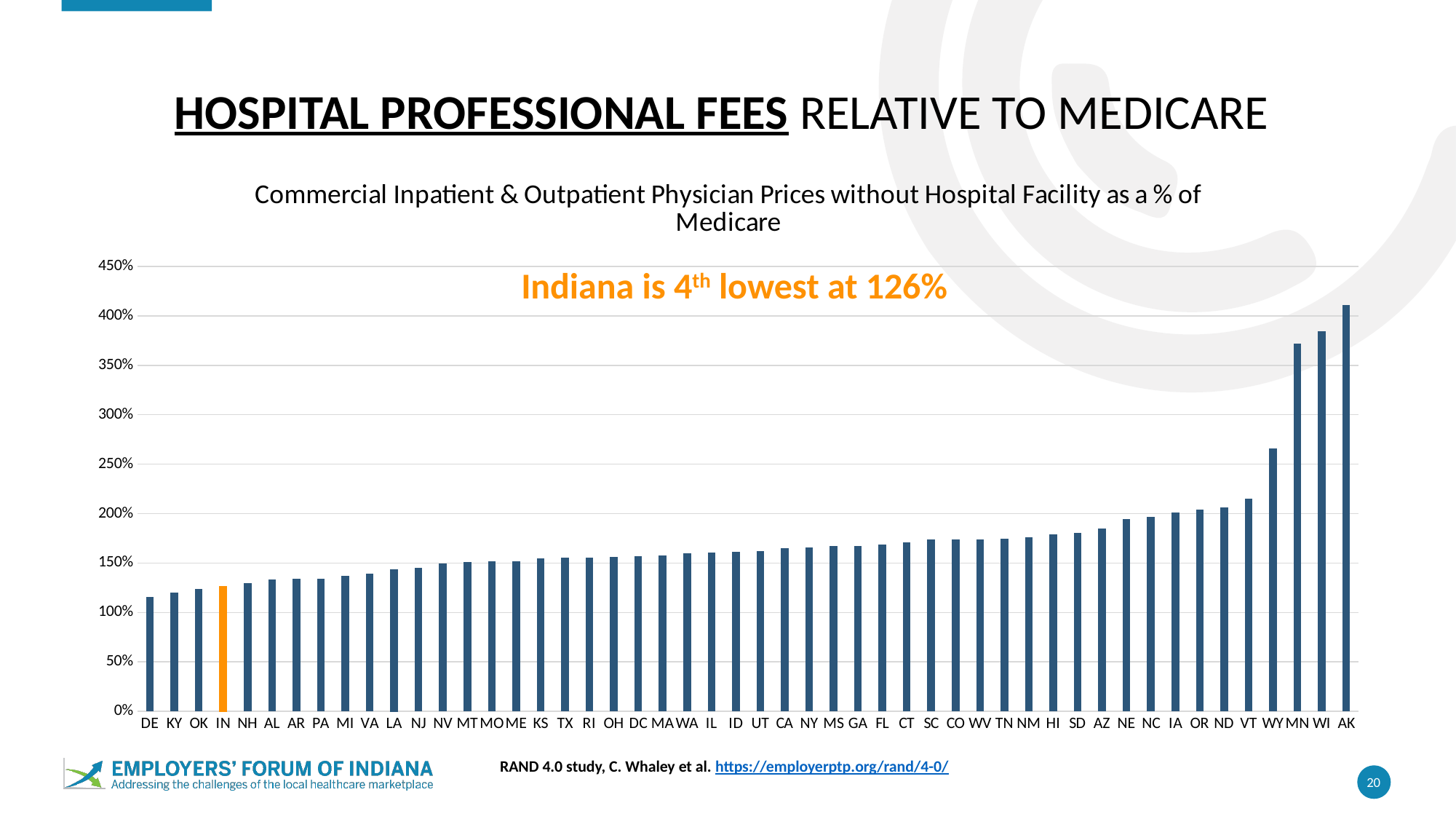
How many states (categories) are plotted on the chart? 50 Which state has the highest value on the chart? AK Is the value for WY greater or less than 250%? greater Which has the larger value, WI or WY? WI Which state has the lowest value on the chart? DE Do the values generally rise or fall moving from left to right along the x axis? Rise Is the value for AK greater or less than 350%? greater According to the annotation on the chart, what rank from the lowest is Indiana? 4th lowest What kind of chart is shown on the slide? Bar chart Which bar is highlighted in orange on the chart? IN Is the value for DE greater or less than 150%? less What value is shown for IN (Indiana) on the chart? 126%